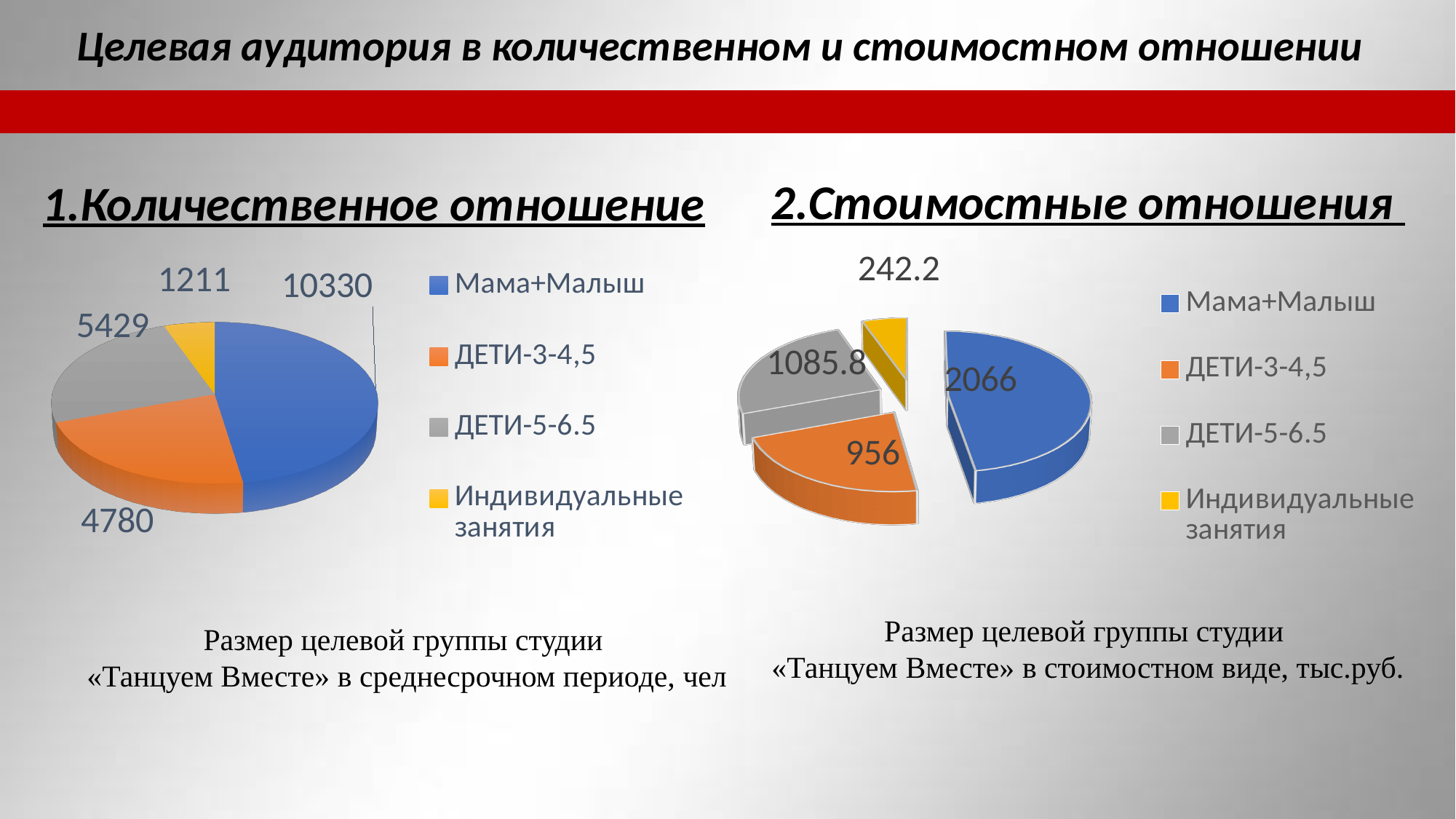
In the left chart (1.Количественное отношение), what is the value for Мама+Малыш? 10330 In the left chart (1.Количественное отношение), what is the difference between Мама+Малыш and ДЕТИ-3-4,5? 5550 In the left chart (1.Количественное отношение), what is the value for ДЕТИ-5-6.5? 5429 In the right chart (2.Стоимостные отношения), what colour is the slice for ДЕТИ-5-6.5? Gray How many categories does the right chart (2.Стоимостные отношения) show? 4 In the right chart (2.Стоимостные отношения), what is the value for Индивидуальные занятия? 242.2 In the left chart (1.Количественное отношение), which category has the smallest slice? Индивидуальные занятия In the left chart (1.Количественное отношение), which is larger: ДЕТИ-5-6.5 or ДЕТИ-3-4,5? ДЕТИ-5-6.5 In the right chart (2.Стоимостные отношения), what is the value for ДЕТИ-3-4,5? 956 What kind of chart is the left chart (1.Количественное отношение)? Pie chart In the right chart (2.Стоимостные отношения), what is the difference between ДЕТИ-5-6.5 and ДЕТИ-3-4,5? 129.8 In the right chart (2.Стоимостные отношения), which category has the largest slice? Мама+Малыш